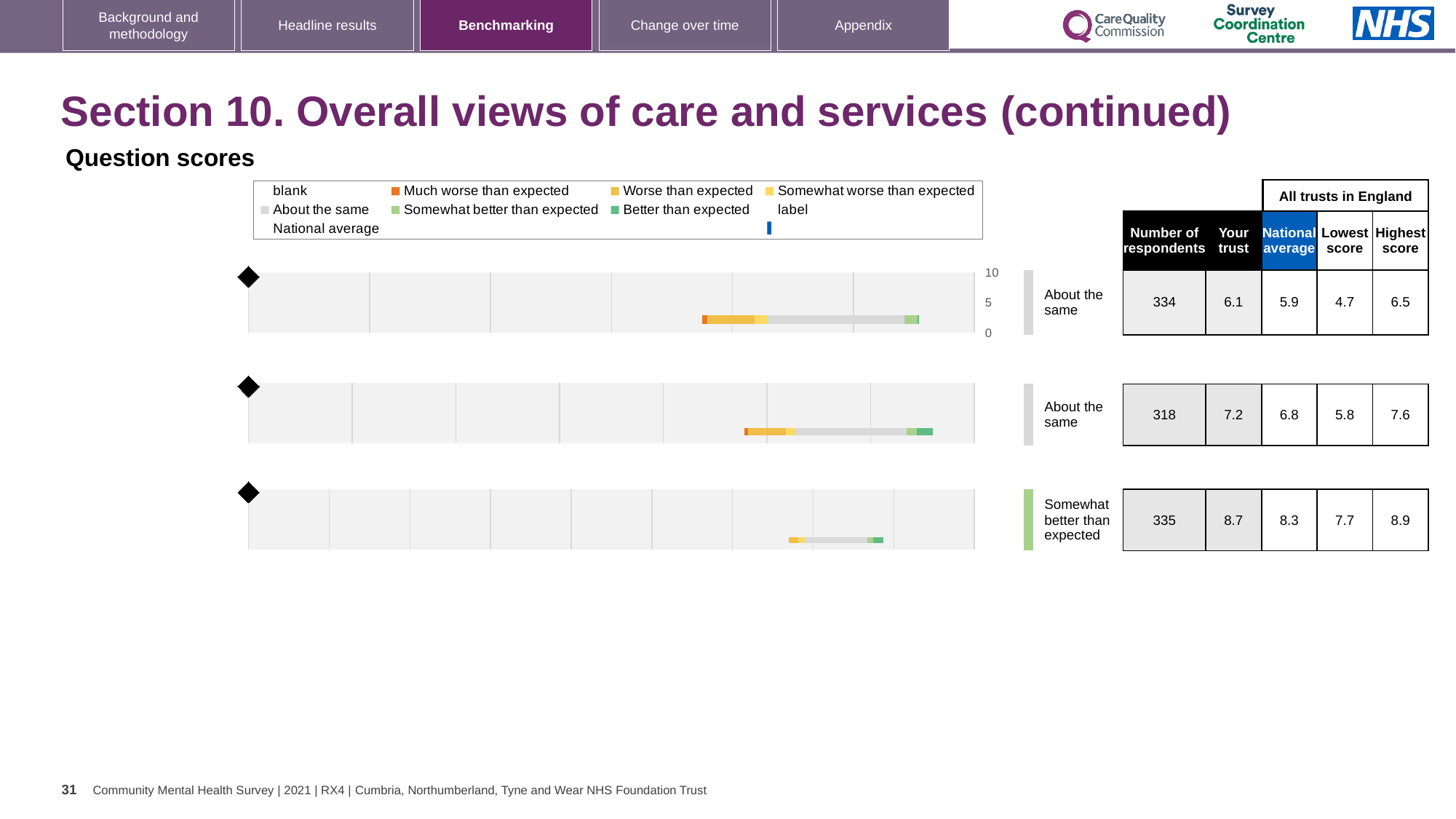
For the middle chart, what is the highest score among all trusts in England? 7.6 How many question charts are shown on the slide? 3 For the bottom chart, which benchmark category is the trust's result placed in? Somewhat better than expected For the bottom chart, which is larger: the 'Your trust' score or the national average? Your trust For the top chart, what is the difference between the 'Your trust' score and the national average? 0.2 For the top chart, what is the national average score? 5.9 For the bottom chart, what is the 'Your trust' score? 8.7 For the middle chart, what is the 'Your trust' score? 7.2 For the bottom chart, what is the lowest score among all trusts in England? 7.7 For the top chart, what is the 'Your trust' score? 6.1 For the top chart, what is the number of respondents shown in the table? 334 Which chart on the slide has the highest 'Your trust' score? The bottom chart